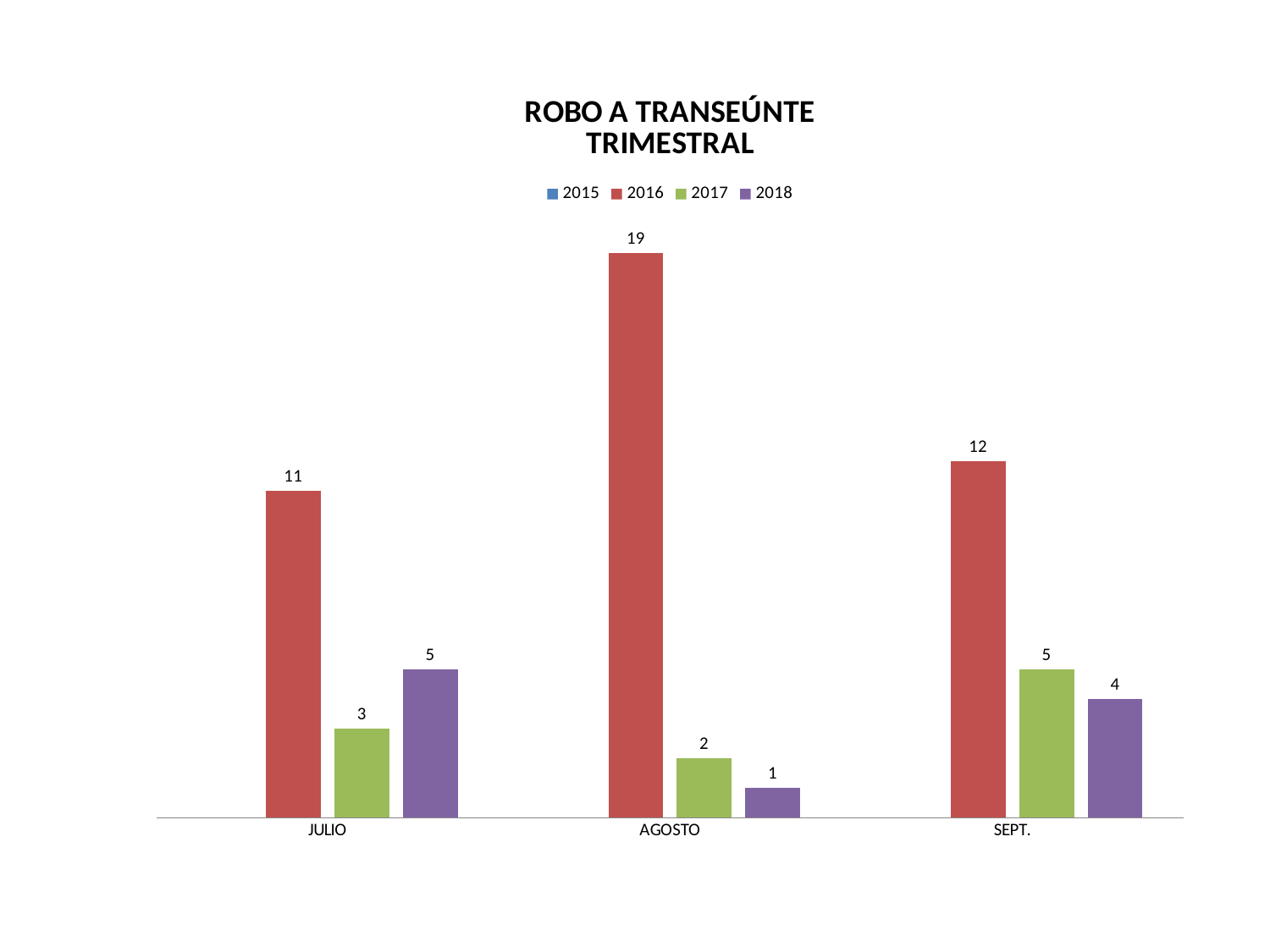
What is the difference between the 2016 and 2017 values in JULIO? 8 Which month has the highest value for the 2016 series? AGOSTO Which month has the lowest value for the 2018 series? AGOSTO What is the title of the chart? ROBO A TRANSEÚNTE TRIMESTRAL What is the value for 2017 in SEPT.? 5 How many series does the legend list? 4 What is the value for 2018 in JULIO? 5 How many months are shown on the x axis? 3 What is the difference between the 2016 values for AGOSTO and SEPT.? 7 Which is larger in SEPT., the value for 2017 or the value for 2018? 2017 What kind of chart is shown on the slide? Bar chart What is the value for 2016 in AGOSTO? 19